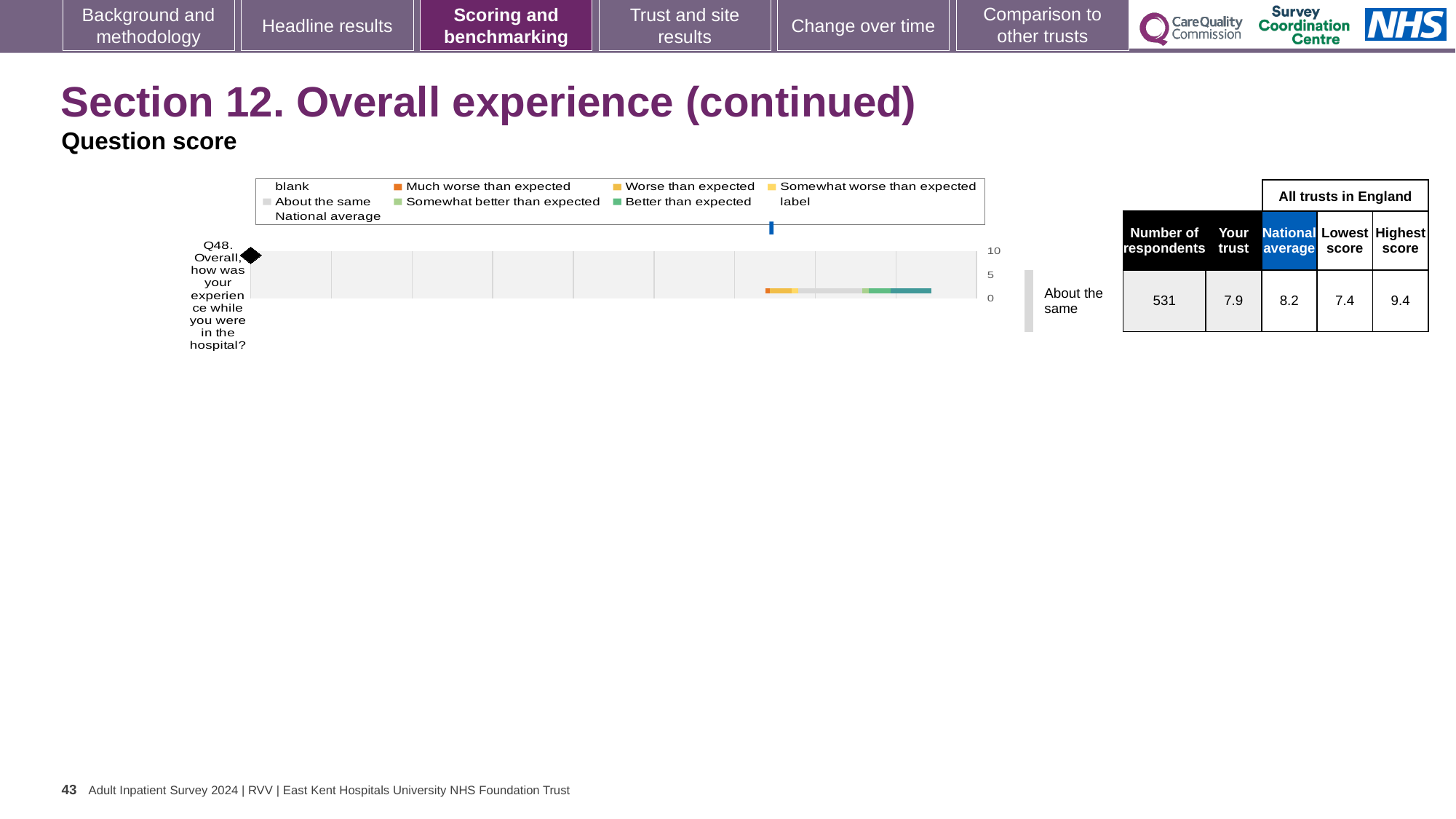
What benchmark category is given for Q48? About the same What is the number of respondents for Q48? 531 What kind of chart is shown on the slide? bar chart What is the highest value shown on the chart's numeric axis? 10 How many survey questions are plotted in the chart? 1 Which question is plotted in the chart? Q48. Overall, how was your experience while you were in the hospital? What is the 'Your trust' score for Q48? 7.9 What is the lowest score among all trusts in England for Q48? 7.4 What is the difference between the national average and the 'Your trust' score for Q48? 0.3 What is the national average score for Q48? 8.2 What is the highest score among all trusts in England for Q48? 9.4 Which is larger for Q48, the 'Your trust' score or the national average? National average